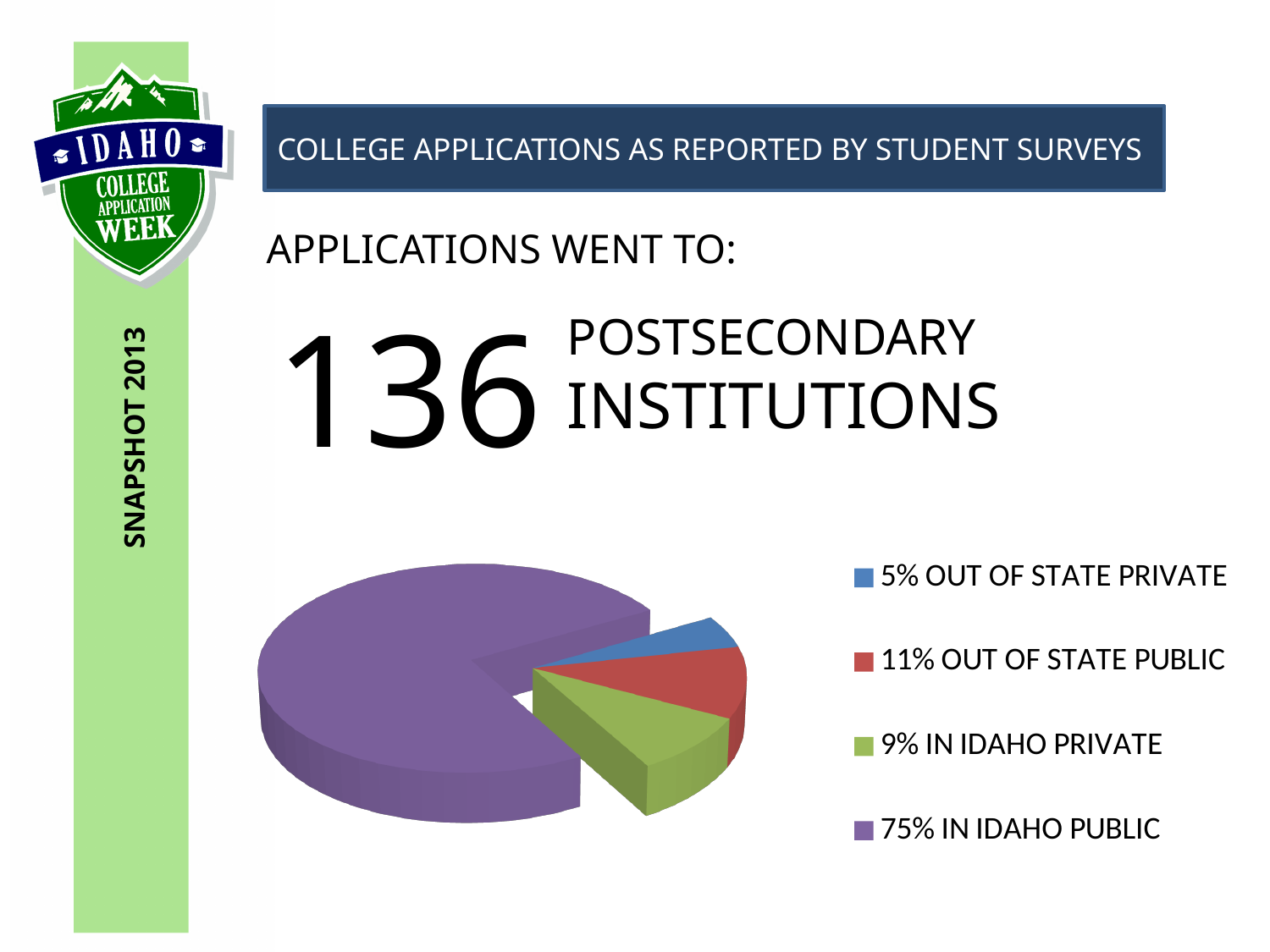
What share of applications went to out of state public institutions? 11% Which is larger, the share for out of state public or the share for in Idaho private? OUT OF STATE PUBLIC Which category has the largest slice of the pie? IN IDAHO PUBLIC What colour is the slice for in Idaho public? purple What share of applications went to in Idaho private institutions? 9% What share of applications went to out of state private institutions? 5% What is the difference in percentage points between in Idaho public and out of state public? 64 What is the combined share of the two out of state categories? 16% Which category has the smallest slice of the pie? OUT OF STATE PRIVATE How many categories does the pie chart show? 4 What kind of chart is shown on the slide? pie chart